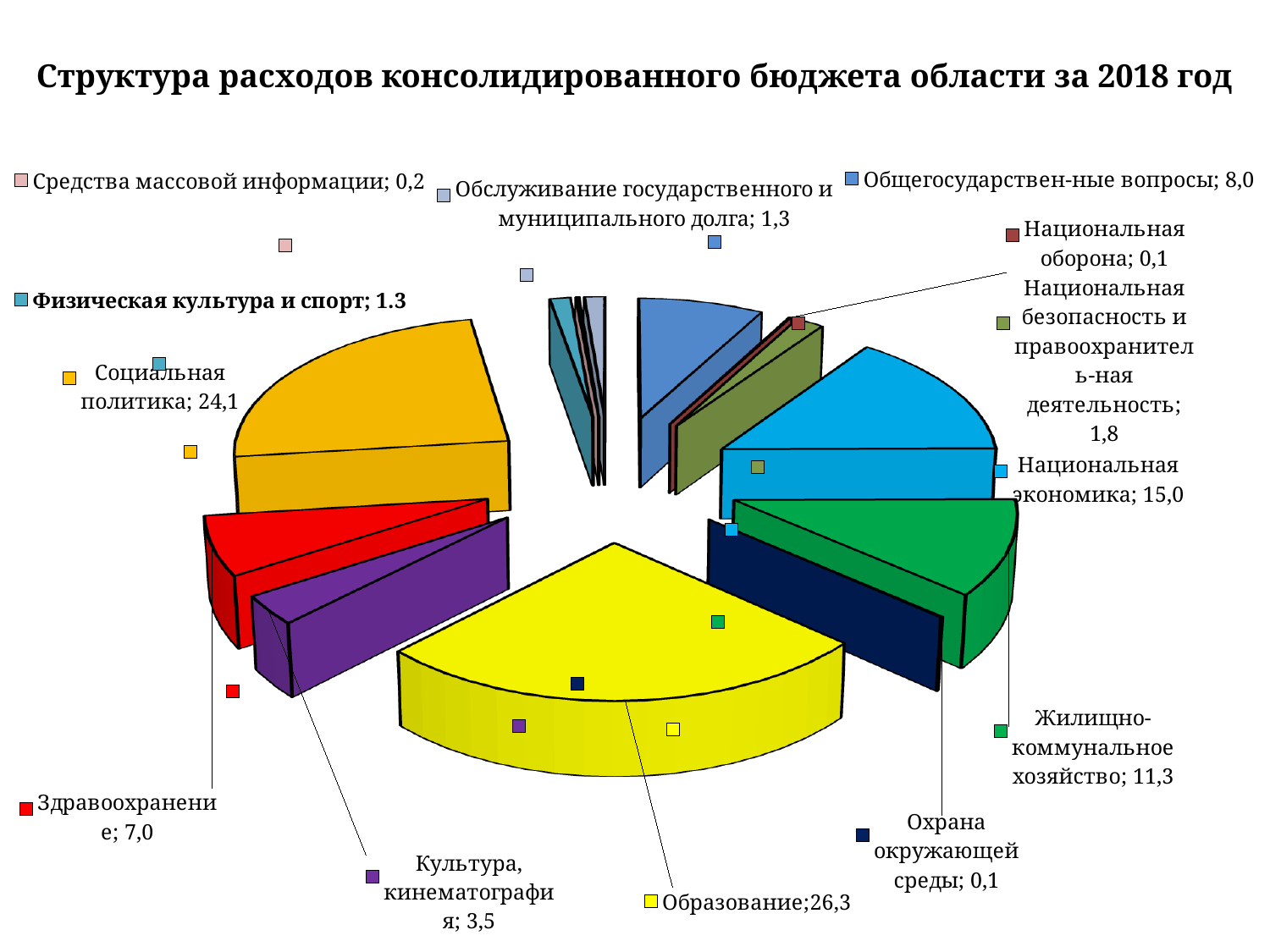
What is the value shown for Жилищно-коммунальное хозяйство? 11,3 Which category has the largest value in the chart? Образование Which is larger, the value for Здравоохранение or the value for Общегосударственные вопросы? Общегосударственные вопросы What type of chart is shown on the slide? Pie chart What is the value shown for Образование? 26,3 What is the difference between the values for Образование and Социальная политика? 2,2 What is the value shown for Социальная политика? 24,1 What is the title of the chart? Структура расходов консолидированного бюджета области за 2018 год What is the value shown for Здравоохранение? 7,0 What is the value shown for Национальная экономика? 15,0 What is the difference between the values for Национальная экономика and Жилищно-коммунальное хозяйство? 3,7 How many categories are shown in the chart? 13